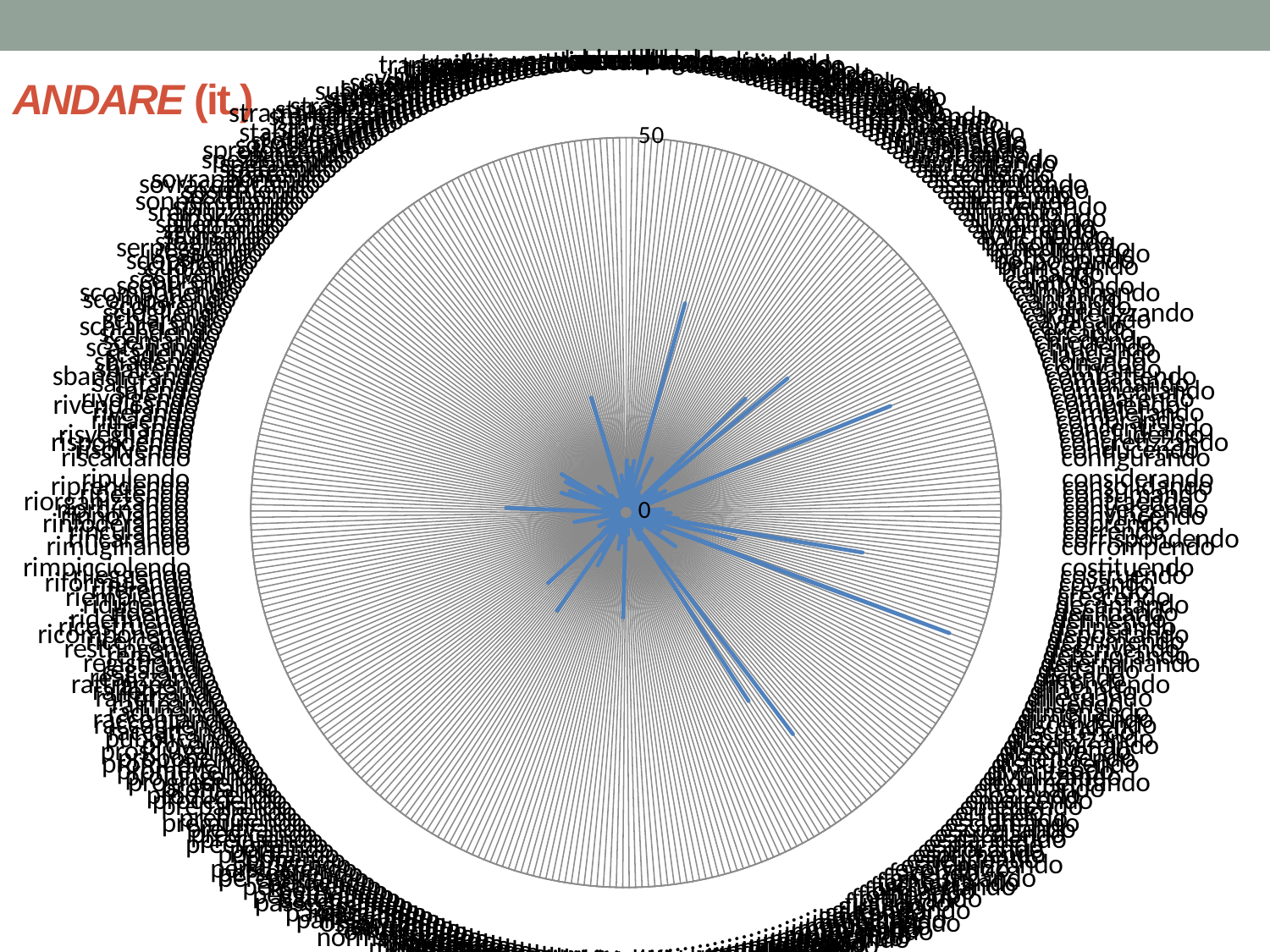
What value is labelled at the centre of the radar chart? 0 Is the highest plotted value on the radar chart greater or less than 50? less What is the highest value labelled on the chart's radial axis? 50 What kind of chart is shown on the slide? radar chart What colour are the plotted data spokes in the radar chart? blue What title appears in the top-left corner of the slide above the chart? ANDARE (it.)